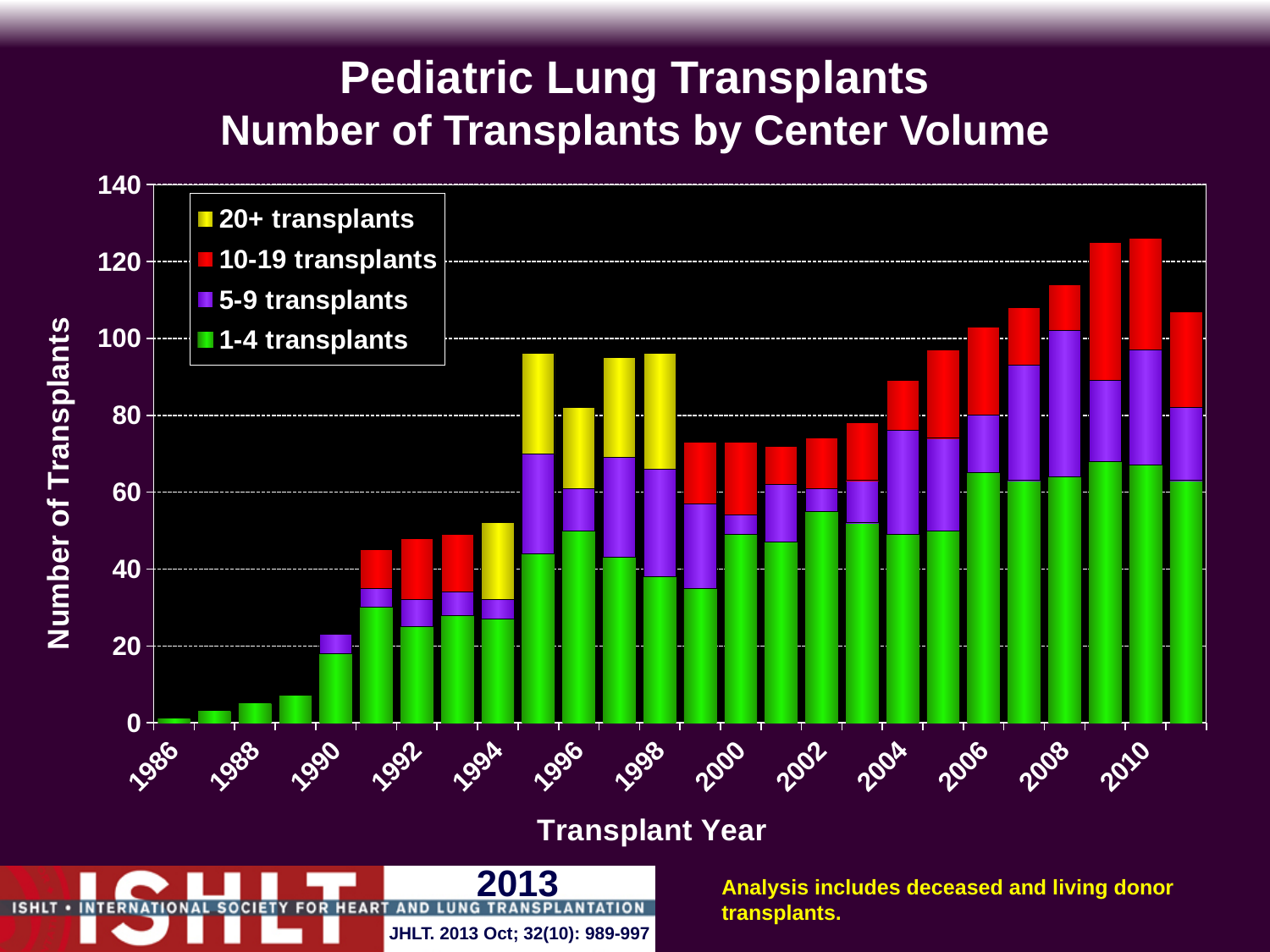
Do the total numbers of transplants generally rise or fall from 2003 to 2010? rise Which year has a larger total number of transplants, 1995 or 2000? 1995 Is the total number of transplants for 1986 greater or less than 20? less Is the total number of transplants for 2010 greater or less than 120? greater Which legend entry is shown in yellow? 20+ transplants Which transplant year has the lowest total number of transplants? 1986 How many transplant years (bars) are plotted on the chart? 26 How many series does the legend list? 4 Is the total number of transplants for 2000 greater or less than 80? less What is the label of the x axis? Transplant Year What kind of chart is shown on the slide? Stacked bar chart